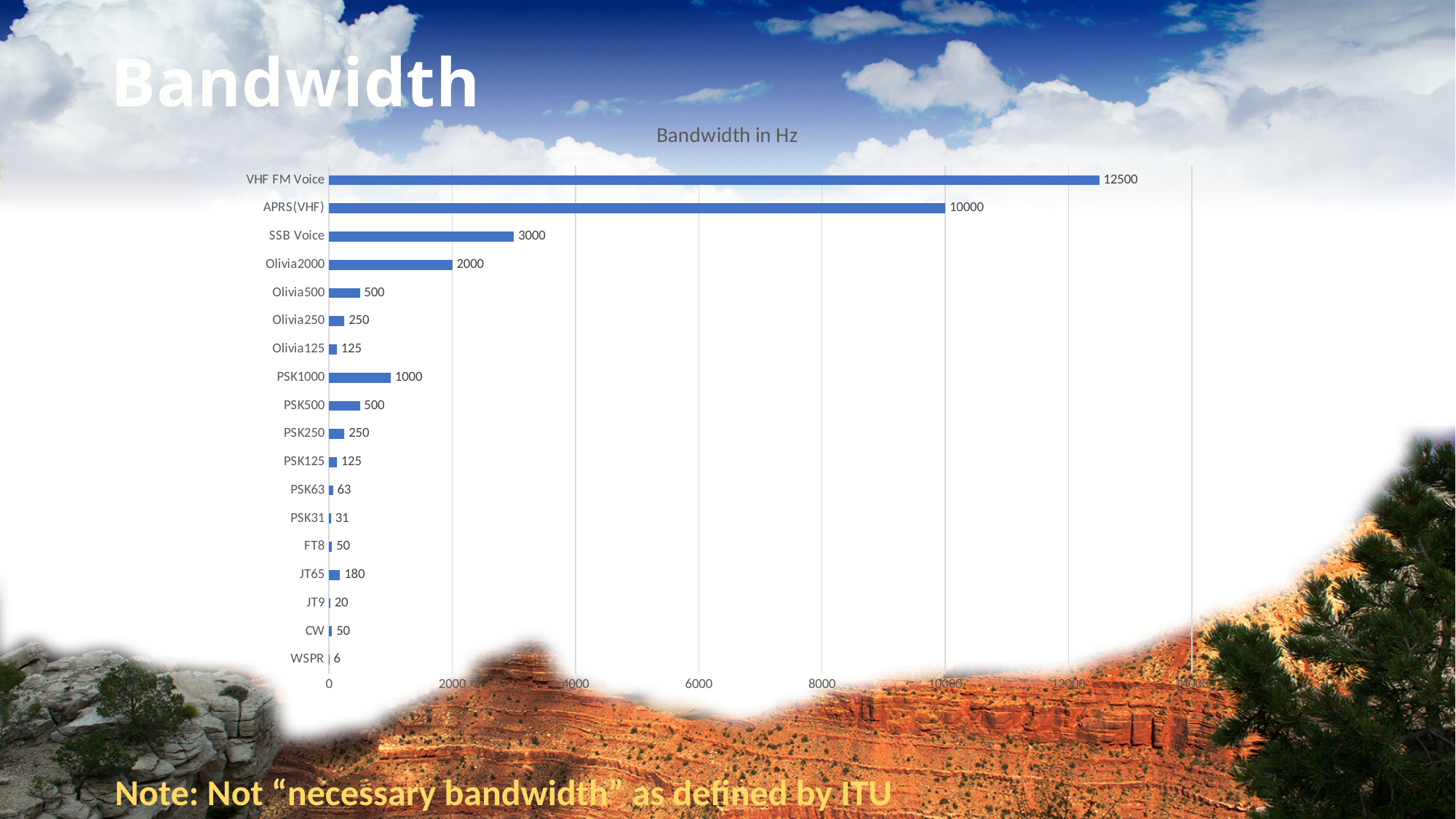
What type of chart is shown on the slide? Bar chart What is the bandwidth value shown for VHF FM Voice? 12500 Which category has the lowest bandwidth in the chart? WSPR What is the bandwidth value shown for JT65? 180 What is the bandwidth value shown for PSK31? 31 What is the difference between the bandwidth of VHF FM Voice and APRS(VHF)? 2500 What is the title of the chart? Bandwidth in Hz How many categories are shown in the chart? 18 Is the value for APRS(VHF) greater or less than 8000? greater What is the difference between the bandwidth of SSB Voice and Olivia2000? 1000 Which has a larger bandwidth, PSK1000 or Olivia500? PSK1000 Which category has the highest bandwidth in the chart? VHF FM Voice